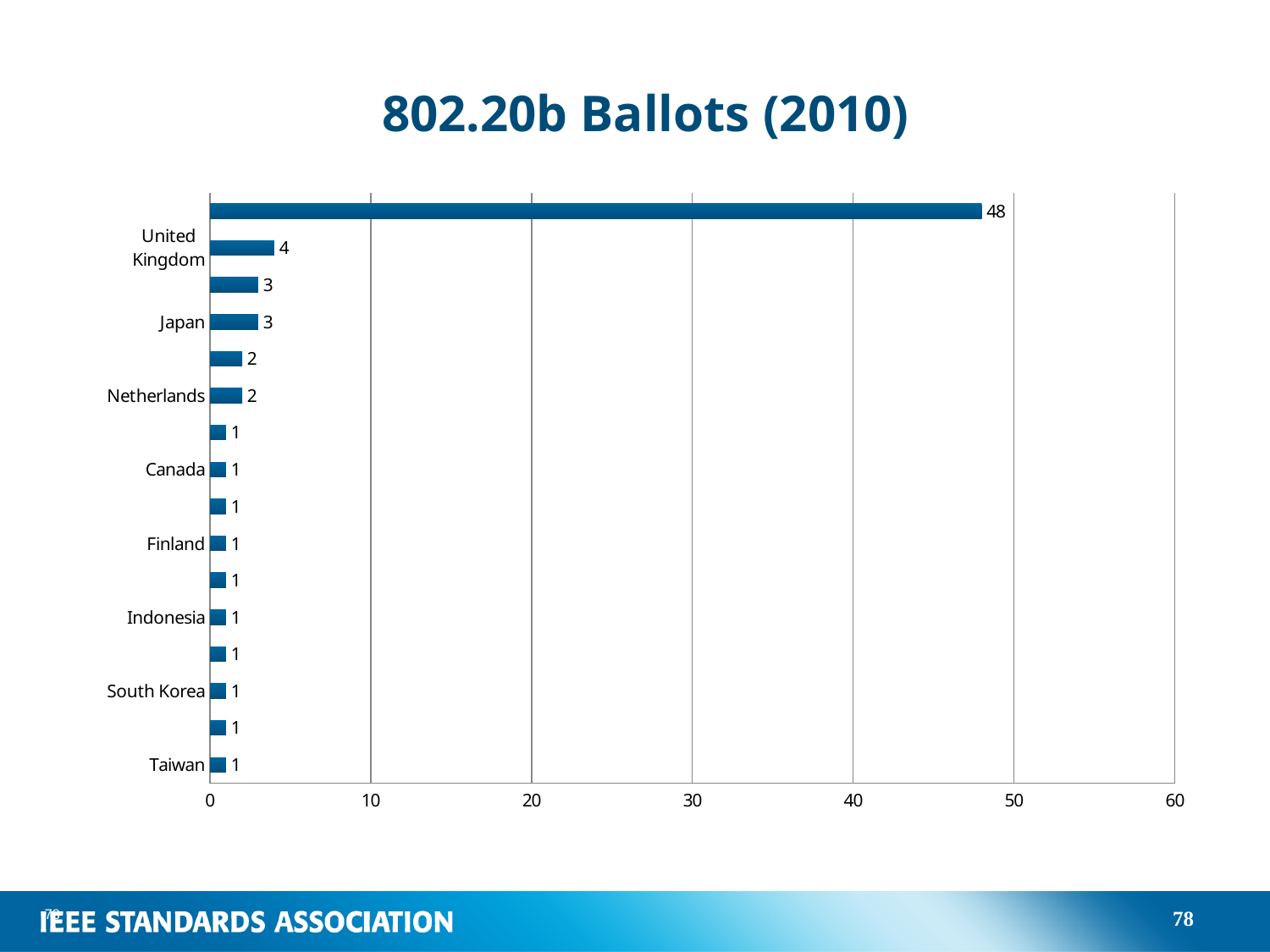
What kind of chart is shown on the slide? bar chart What is the value for Japan? 3 What is the value for Canada? 1 What is the largest value shown on the chart? 48 Which has the larger value, United Kingdom or Japan? United Kingdom How many bars are plotted on the chart? 16 Is the value of the longest bar greater or less than 40? greater What is the value for United Kingdom? 4 What is the value for Netherlands? 2 What is the difference between the values for United Kingdom and Japan? 1 What is the value for Taiwan? 1 What is the difference between the values for United Kingdom and Netherlands? 2